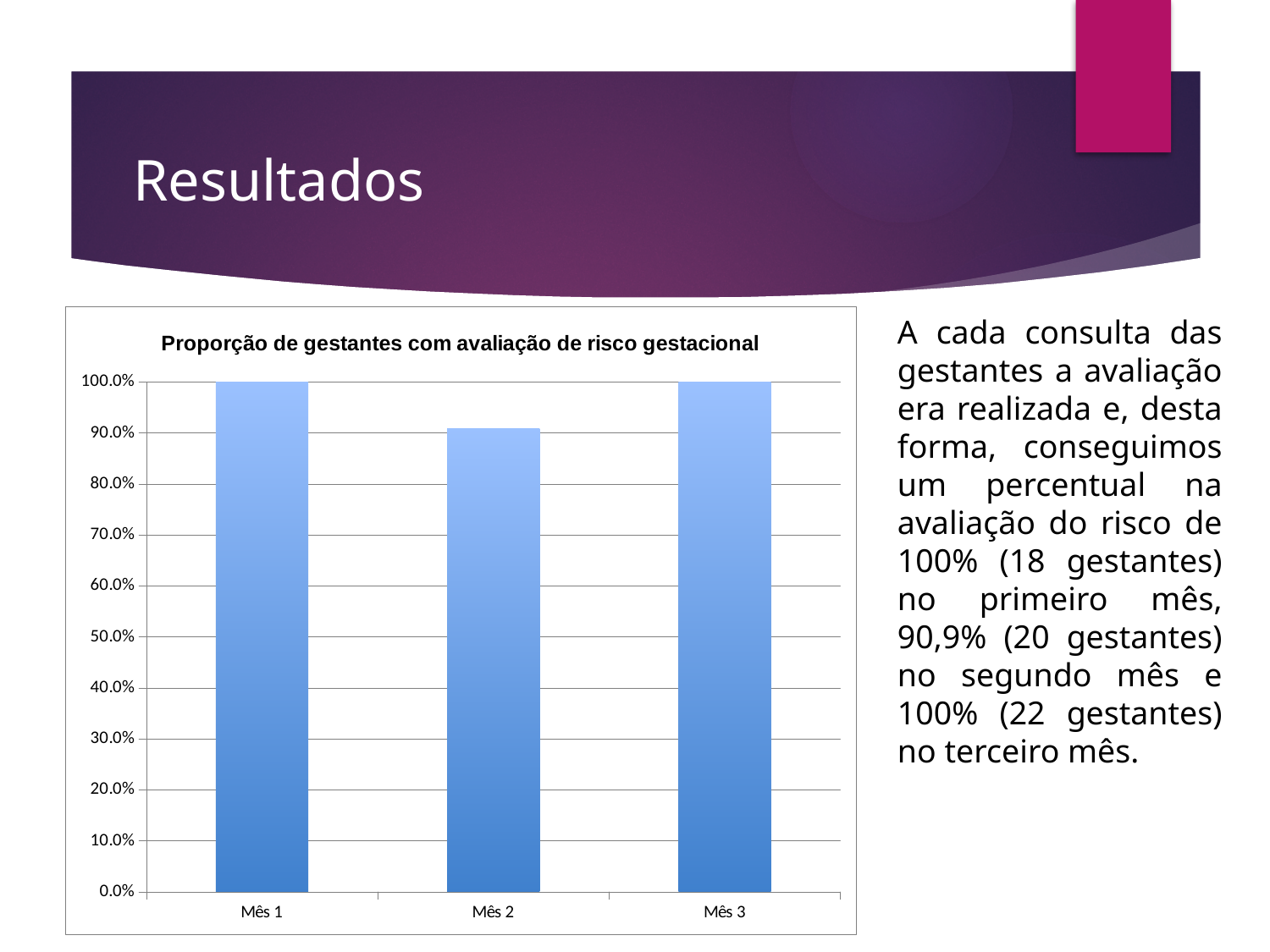
What kind of chart is shown on the slide? bar chart What is the value for Mês 3? 100.0% Does the value rise or fall from Mês 1 to Mês 2? fall What is the difference between the values for Mês 1 and Mês 3? 0.0% Which is larger, the value for Mês 1 or the value for Mês 2? Mês 1 Is the value for Mês 2 greater or less than 80.0%? greater How many months are shown on the x axis? 3 What is the value for Mês 1? 100.0% Which month has the lowest proportion? Mês 2 What is the title of the chart? Proporção de gestantes com avaliação de risco gestacional Which is larger, the value for Mês 2 or the value for Mês 3? Mês 3 Is the value for Mês 2 greater or less than 100.0%? less